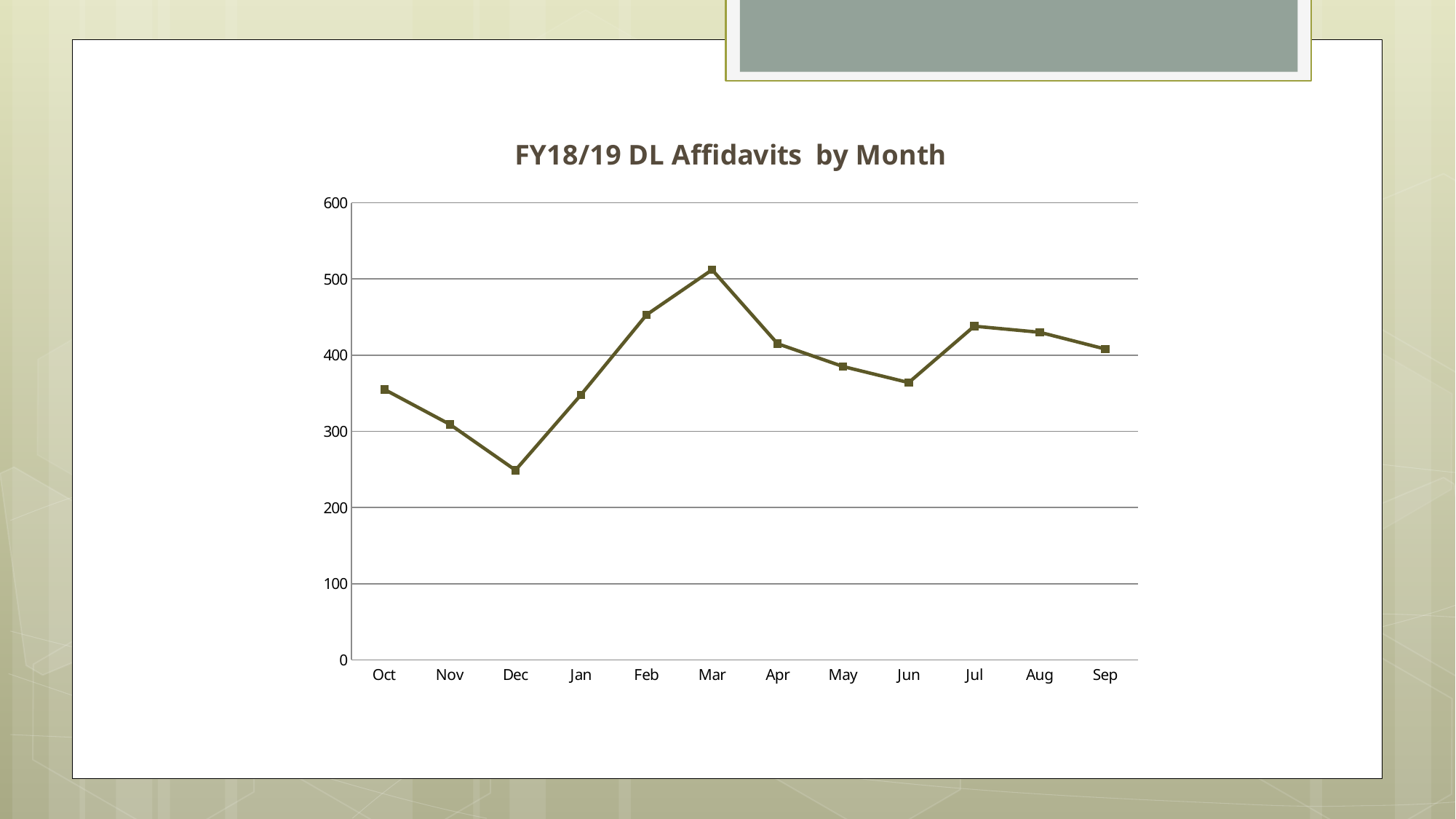
Which is larger, the value for Feb or the value for Apr? Feb Is the value for Jun greater or less than 400? less How many months are plotted on the x axis? 12 What kind of chart is shown on the slide? line chart Do the values rise or fall from Dec to Mar? rise Which month has the highest value? Mar Is the value for Oct greater or less than 300? greater Do the values rise or fall from Oct to Dec? fall Which month has the lowest value? Dec Is the value for Dec greater or less than 300? less What is the title of the chart? FY18/19 DL Affidavits by Month